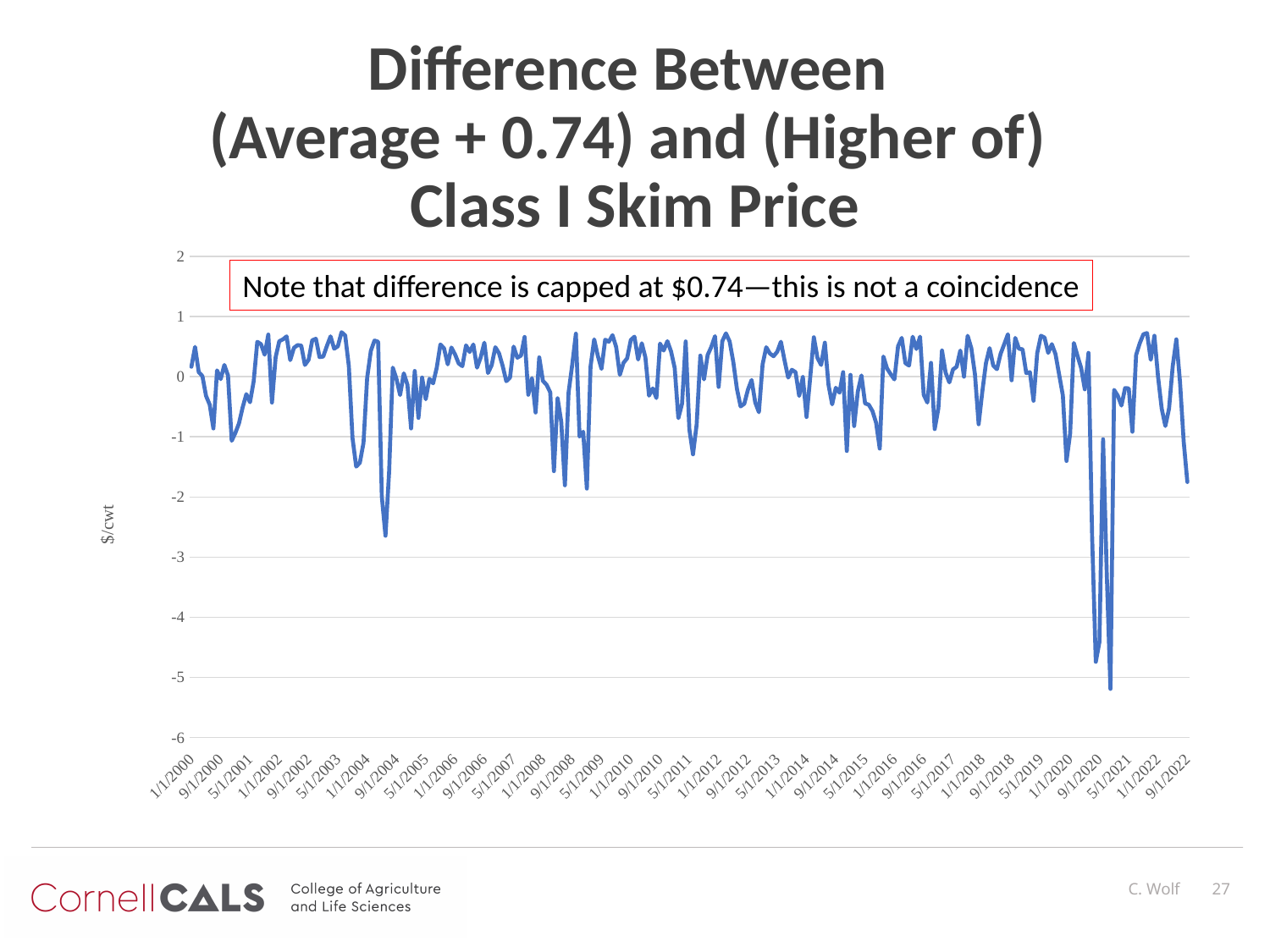
How many lines are plotted on the chart? 1 Is the value at the start of the series, at 1/1/2000, greater or less than 0? greater What unit is shown on the vertical axis of the chart? $/cwt What kind of chart is shown on the slide? line chart In which year does the line reach its lowest value? 2020 Which dip is lower: the one around 2004 or the one around 2020? 2020 What is the title of the chart? Difference Between (Average + 0.74) and (Higher of) Class I Skim Price Is the lowest value of the line, reached in 2020, greater or less than -4? less Is the value at the dip around 9/1/2004 greater or less than -2? less Which dip is lower: the one around 2004 or the one around 2008? 2004